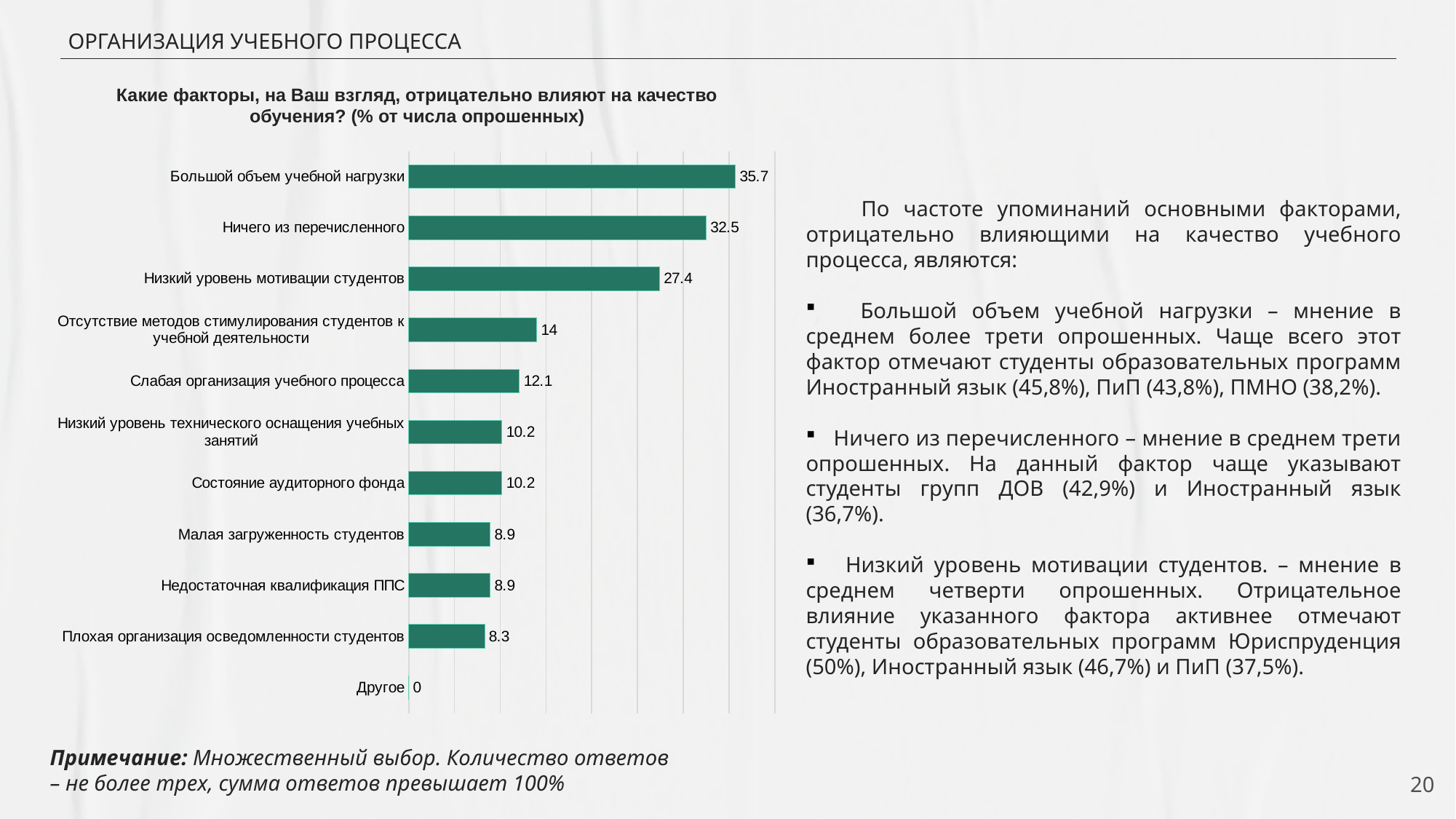
What is the value for "Большой объем учебной нагрузки"? 35.7 What is the title of the chart? Какие факторы, на Ваш взгляд, отрицательно влияют на качество обучения? (% от числа опрошенных) What kind of chart is shown on the slide? Bar chart What is the value for "Низкий уровень мотивации студентов"? 27.4 How many categories are shown in the chart? 11 What is the difference between the values for "Низкий уровень мотивации студентов" and "Малая загруженность студентов"? 18.5 What is the value for "Слабая организация учебного процесса"? 12.1 Which is larger: the value for "Отсутствие методов стимулирования студентов к учебной деятельности" or for "Слабая организация учебного процесса"? Отсутствие методов стимулирования студентов к учебной деятельности What is the difference between the values for "Большой объем учебной нагрузки" and "Ничего из перечисленного"? 3.2 Which category has the highest value? Большой объем учебной нагрузки What is the value for "Другое"? 0 Which category has the lowest value? Другое